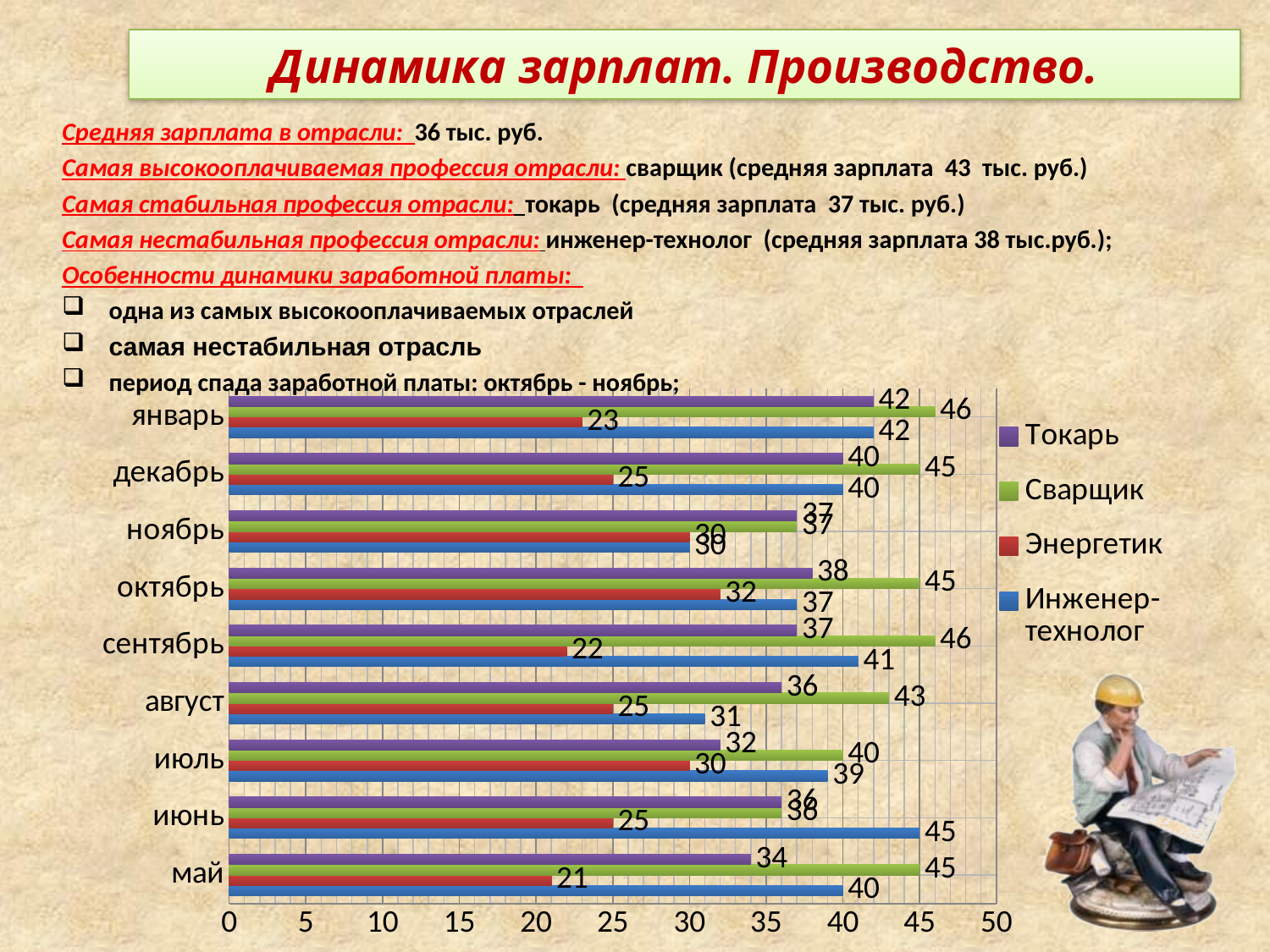
In which month is the value for Энергетик lowest? май What is the value for Сварщик in январь? 46 What is the value for Инженер-технолог in июнь? 45 What is the value for Токарь in октябрь? 38 Which is larger in август: Инженер-технолог or Токарь? Токарь How many months are shown on the chart? 9 Which series is shown in green? Сварщик How many series does the legend list? 4 In which month is the value for Токарь highest? январь What is the difference between Сварщик and Энергетик in сентябрь? 24 What is the value for Энергетик in май? 21 What kind of chart is shown on the slide? bar chart